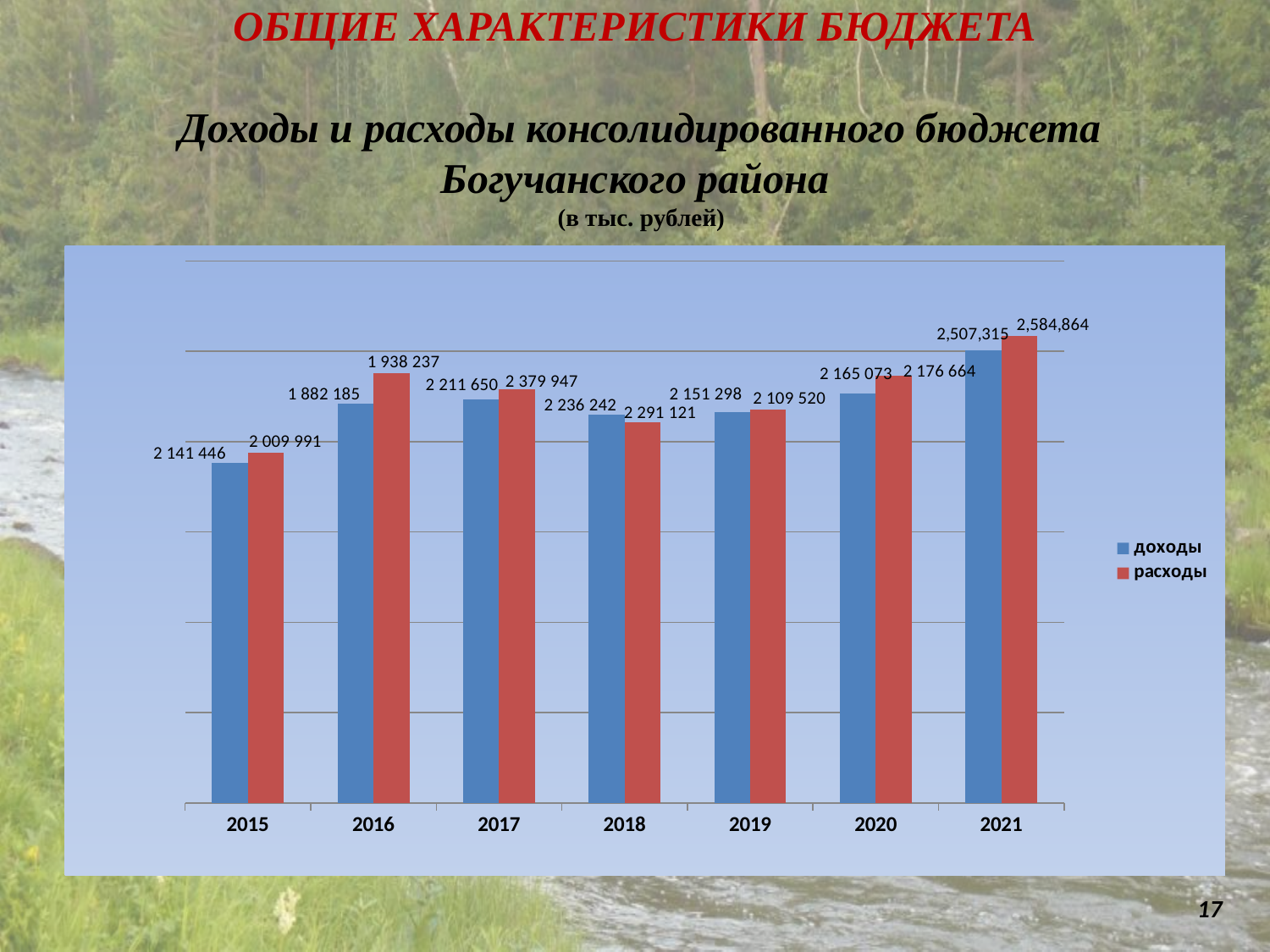
What type of chart is shown on the slide? bar chart How many years are shown on the x axis? 7 What is the value of расходы for 2018? 2 291 121 Which series is shown in red in the legend? расходы What is the value of расходы for 2016? 1 938 237 Which year has the highest value of расходы? 2021 Which year has the highest value of доходы? 2021 What is the value of доходы for 2021? 2,507,315 What is the value of доходы for 2017? 2 211 650 How many series does the legend list? 2 What is the difference between расходы and доходы in 2017? 168 297